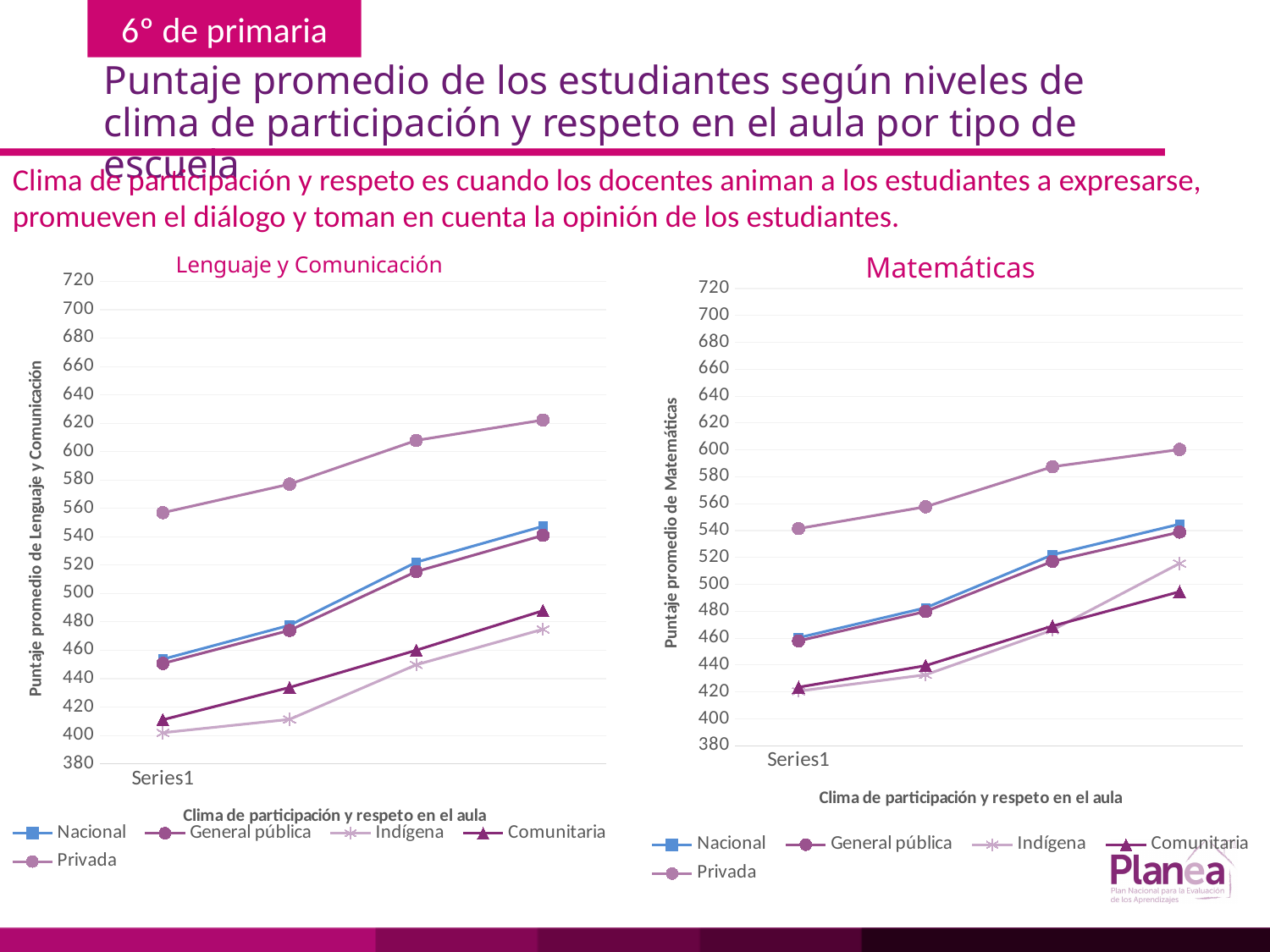
In the Lenguaje y Comunicación chart, do the values for Privada rise or fall along the x axis? rise What is the y-axis label of the Matemáticas chart? Puntaje promedio de Matemáticas In the Matemáticas chart, at the last point, which is higher: Indígena or Comunitaria? Indígena How many points does each series have in the Matemáticas chart? 4 In the Matemáticas chart, which series has the highest values across all points? Privada In the Lenguaje y Comunicación chart, is the first value for Indígena greater or less than 420? less In the Lenguaje y Comunicación chart, which series has the highest values across all points? Privada What kind of chart is the Lenguaje y Comunicación chart? line chart How many series does the legend of the Matemáticas chart list? 5 In the Lenguaje y Comunicación chart, is the first value for Privada greater or less than 540? greater In the Matemáticas chart, is the last value for Indígena greater or less than 500? greater